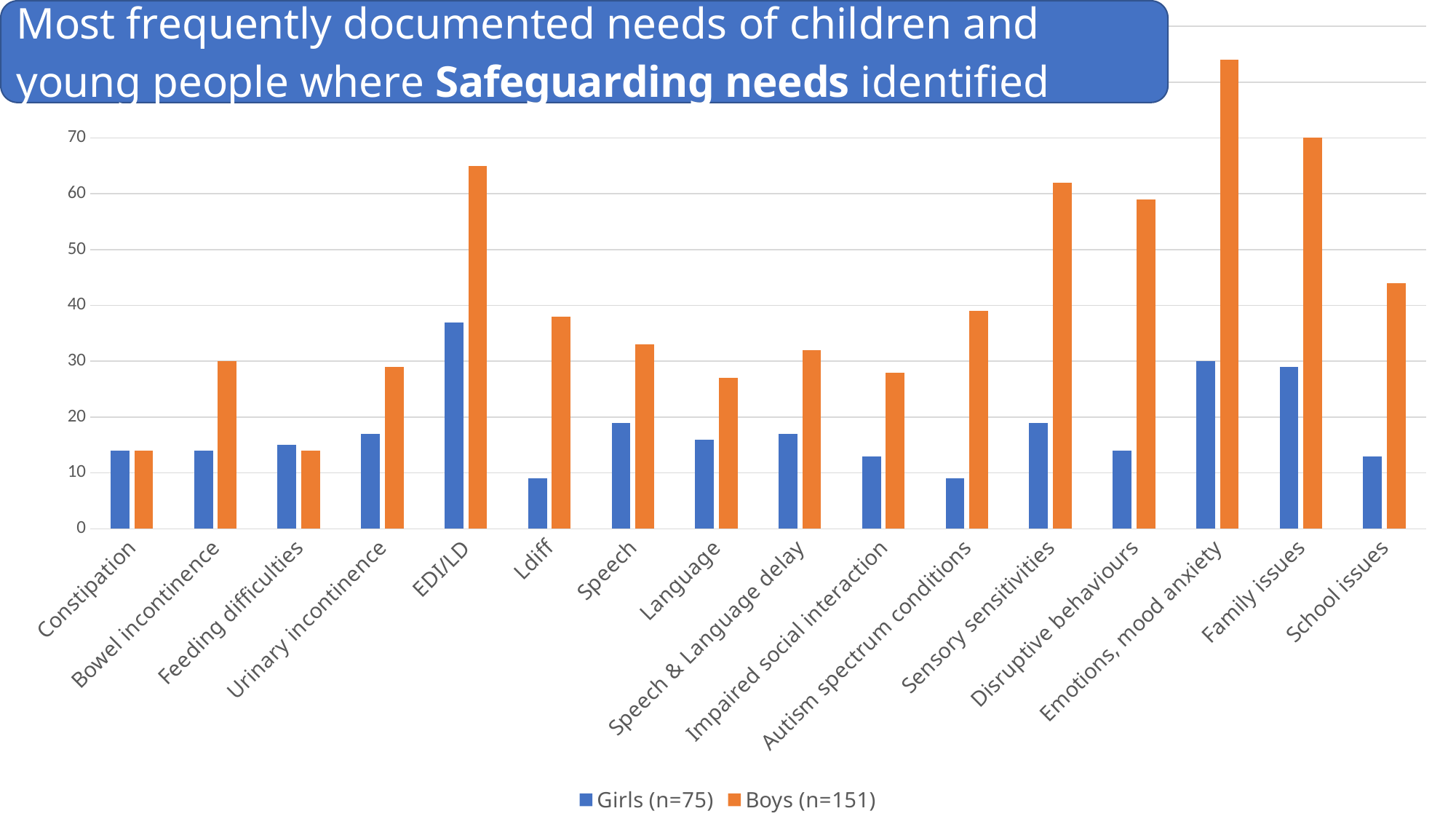
For Disruptive behaviours, which series has the larger value, Girls (n=75) or Boys (n=151)? Boys (n=151) Is the value for Girls (n=75) for Speech greater or less than 20? less Is the value for Girls (n=75) for EDI/LD greater or less than 30? greater Which series is shown in orange? Boys (n=151) Which category has the highest value for Boys (n=151)? Emotions, mood anxiety Is the value for Boys (n=151) for School issues greater or less than 40? greater How many series does the legend list? 2 Which category has the highest value for Girls (n=75)? EDI/LD What are the two legend entries of the chart? Girls (n=75) and Boys (n=151) What kind of chart is shown on the slide? bar chart How many categories are shown along the x axis? 16